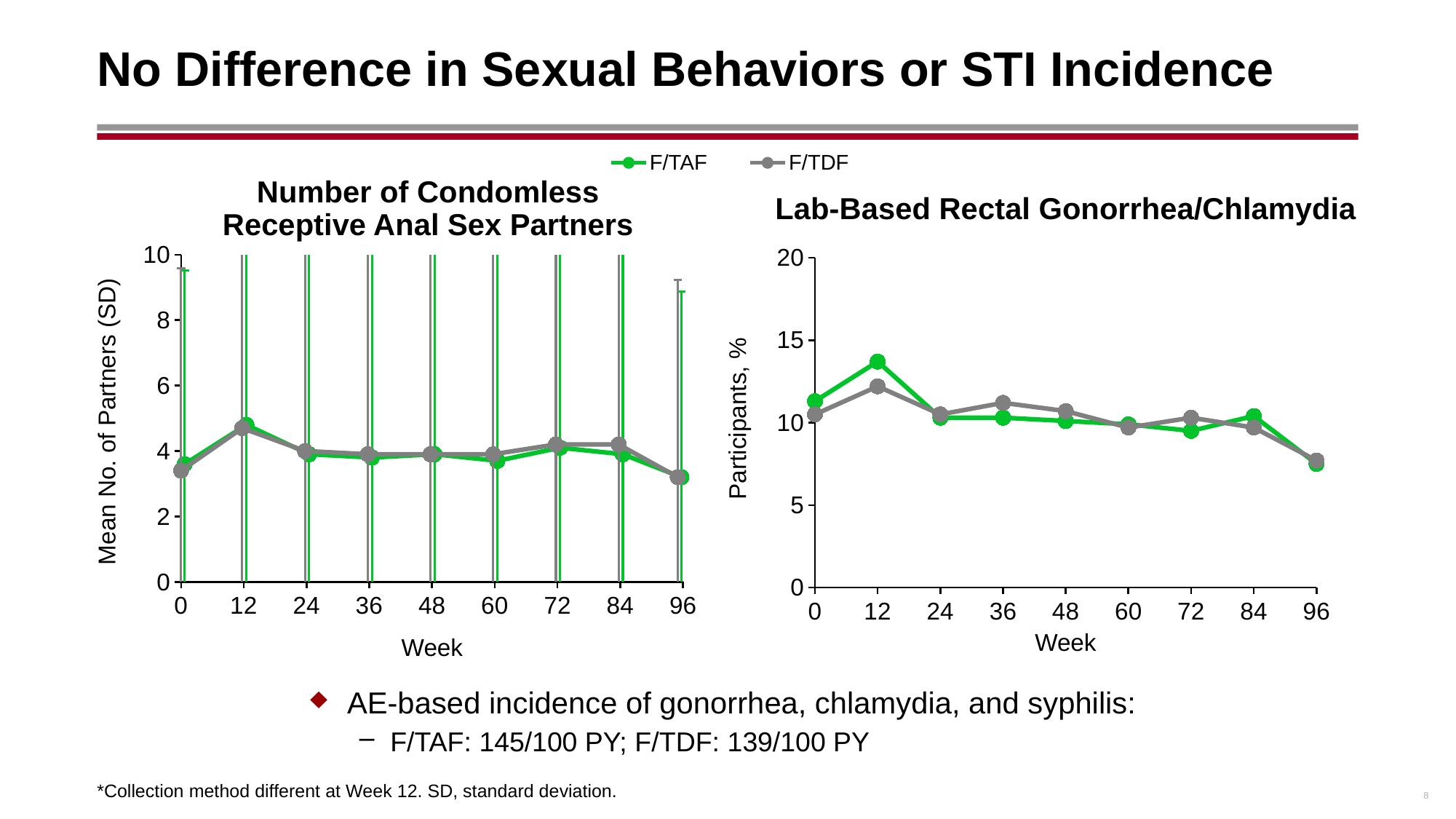
In the 'Number of Condomless Receptive Anal Sex Partners' chart, is the F/TAF value at week 12 greater or less than 4? greater How many series does the legend list for the charts on this slide? 2 What is the y-axis label of the 'Lab-Based Rectal Gonorrhea/Chlamydia' chart? Participants, % In the 'Number of Condomless Receptive Anal Sex Partners' chart, how many week time points are plotted on the x axis? 9 What kind of chart is the 'Lab-Based Rectal Gonorrhea/Chlamydia' chart? Line chart In the 'Number of Condomless Receptive Anal Sex Partners' chart, is the F/TDF value at week 96 greater or less than 4? less In the 'Lab-Based Rectal Gonorrhea/Chlamydia' chart, which series has the higher value at week 12, F/TAF or F/TDF? F/TAF In the 'Lab-Based Rectal Gonorrhea/Chlamydia' chart, at which week is the F/TAF value lowest? Week 96 In the 'Lab-Based Rectal Gonorrhea/Chlamydia' chart, do the F/TAF values generally rise or fall from week 12 to week 96? Fall In the 'Lab-Based Rectal Gonorrhea/Chlamydia' chart, is the F/TDF value at week 96 greater or less than 10? less In the 'Lab-Based Rectal Gonorrhea/Chlamydia' chart, at which week is the F/TAF value highest? Week 12